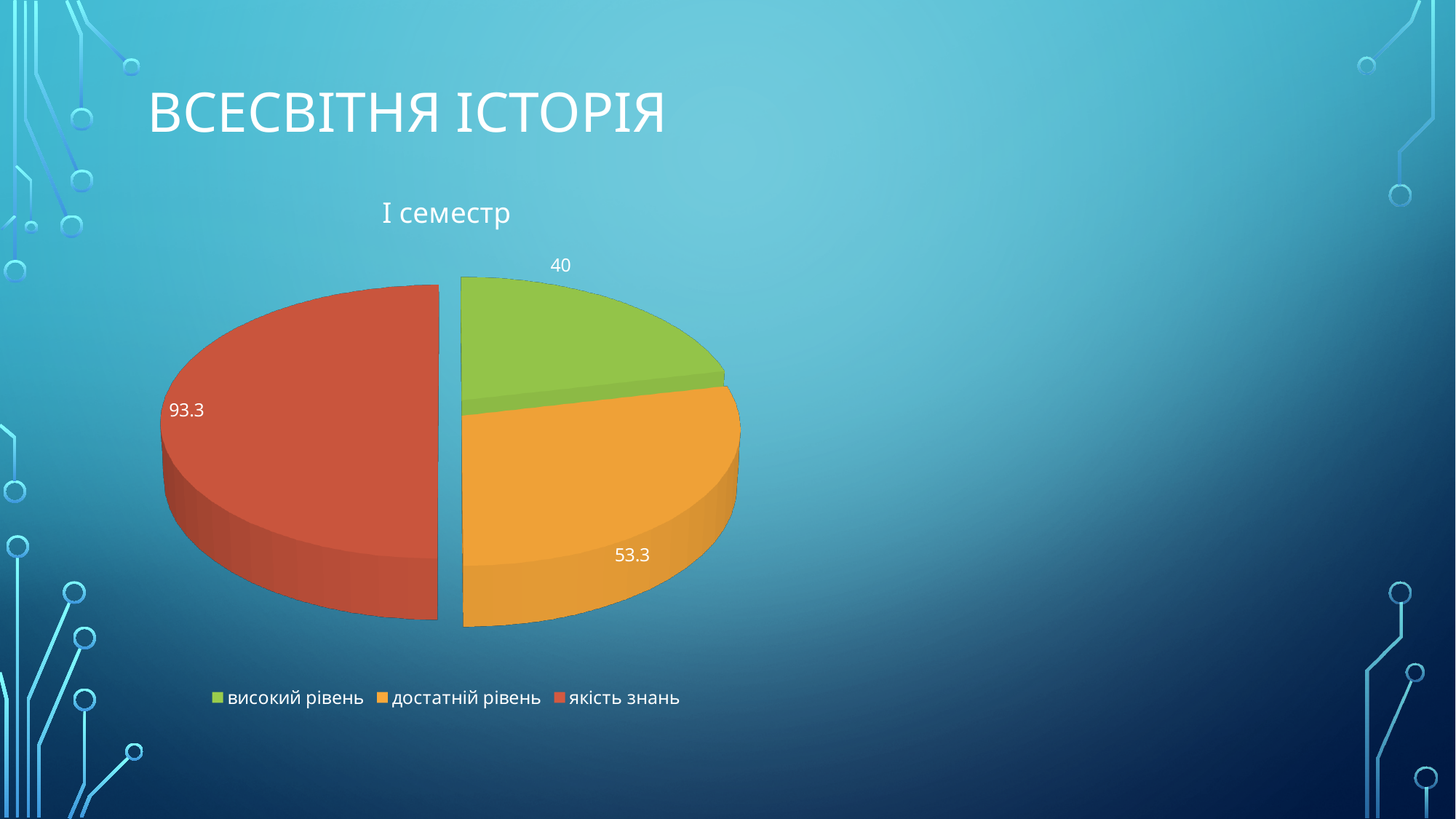
What is the difference between the values for достатній рівень and високий рівень? 13.3 What type of chart is shown on the slide? pie chart What is the value for високий рівень? 40 Which category has the smallest slice? високий рівень What is the title of the chart? І семестр How many slices does the pie chart have? 3 Which is larger, the value for достатній рівень or the value for високий рівень? достатній рівень What share of the pie does the якість знань slice represent? 50% What is the difference between the values for якість знань and достатній рівень? 40 What is the value for якість знань? 93.3 What is the value for достатній рівень? 53.3 Which category has the largest slice? якість знань